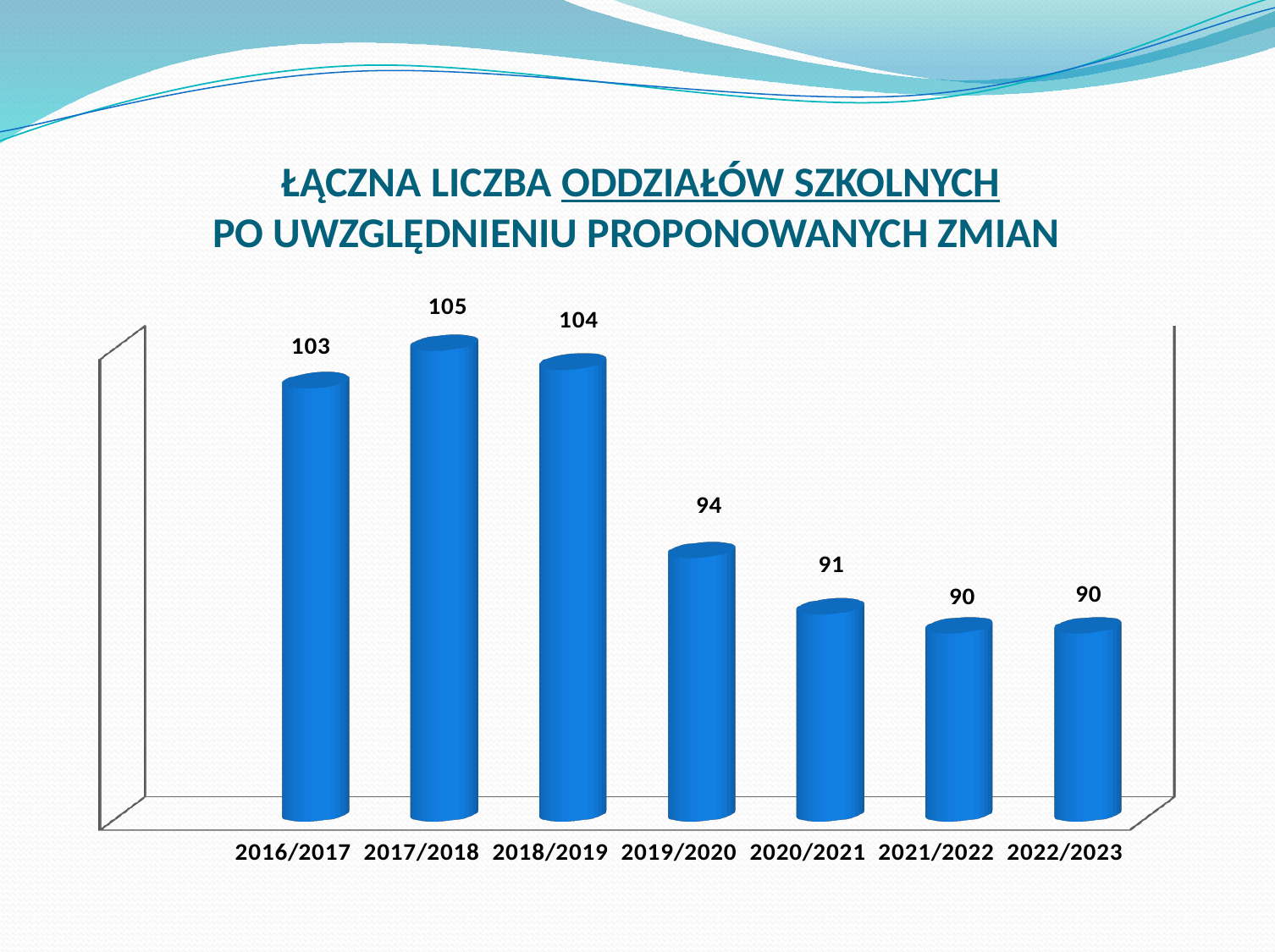
What is the value for 2019/2020? 94 What is the difference between the values for 2018/2019 and 2019/2020? 10 What kind of chart is shown on the slide? bar chart What is the value for 2016/2017? 103 Which is larger, the value for 2016/2017 or the value for 2020/2021? 2016/2017 Which school year has the highest value? 2017/2018 How many school years are shown on the x axis? 7 Do the values generally rise or fall from 2017/2018 to 2022/2023? fall What is the difference between the values for 2017/2018 and 2022/2023? 15 What is the title of the chart? ŁĄCZNA LICZBA ODDZIAŁÓW SZKOLNYCH PO UWZGLĘDNIENIU PROPONOWANYCH ZMIAN What is the value for 2022/2023? 90 What is the value for 2020/2021? 91